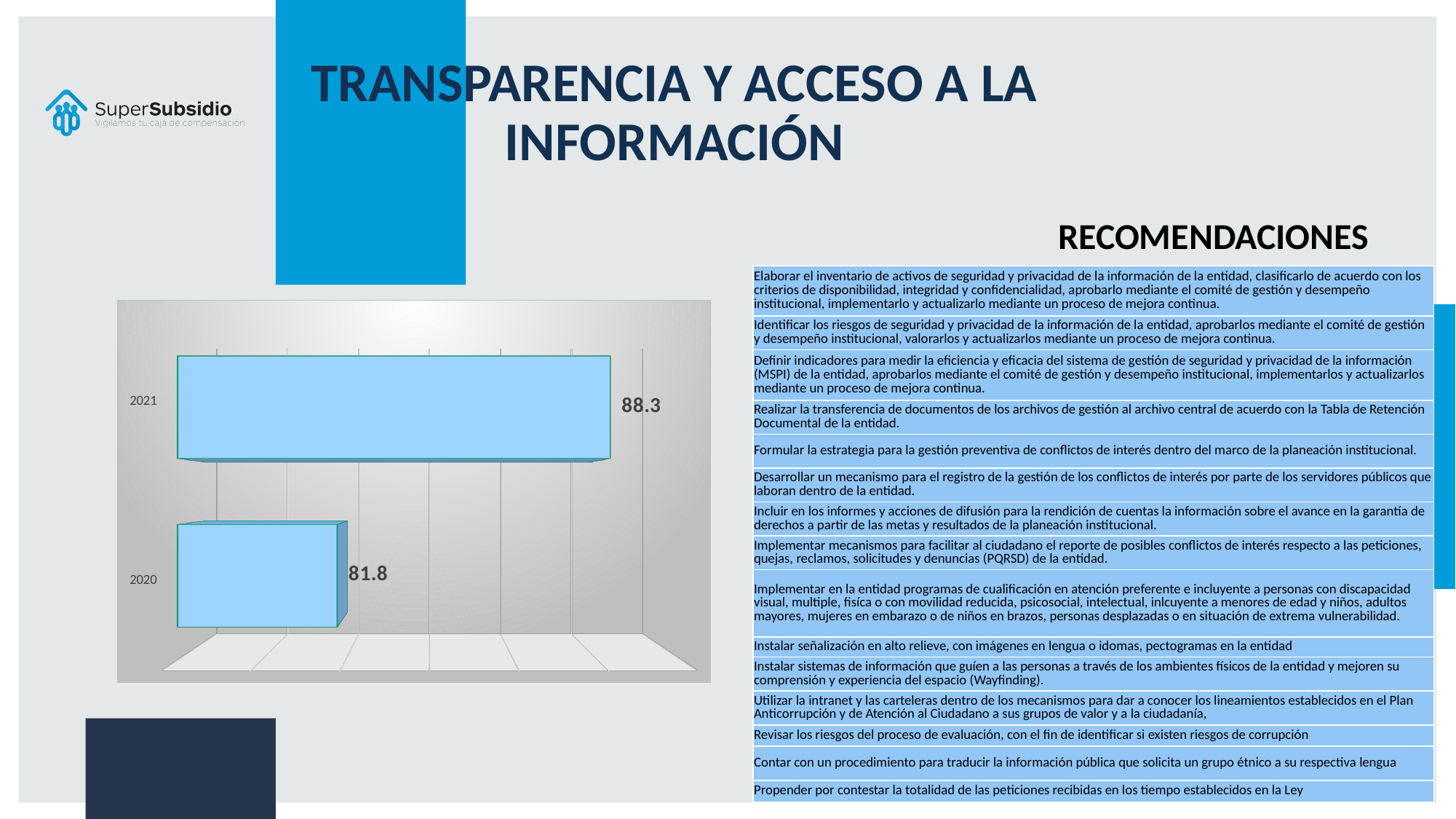
How many categories are shown in the bar chart? 2 What kind of chart is shown on the slide? Bar chart What is the value for 2021 in the bar chart? 88.3 Which years are shown as categories in the bar chart? 2021 and 2020 Which is larger in the bar chart, the value for 2020 or the value for 2021? 2021 Which year has the lowest value in the bar chart? 2020 What is the difference between the values for 2021 and 2020 in the bar chart? 6.5 What is the value for 2020 in the bar chart? 81.8 Did the value rise or fall from 2020 to 2021 in the bar chart? Rise What colour are the bars in the chart? Light blue Which year has the highest value in the bar chart? 2021